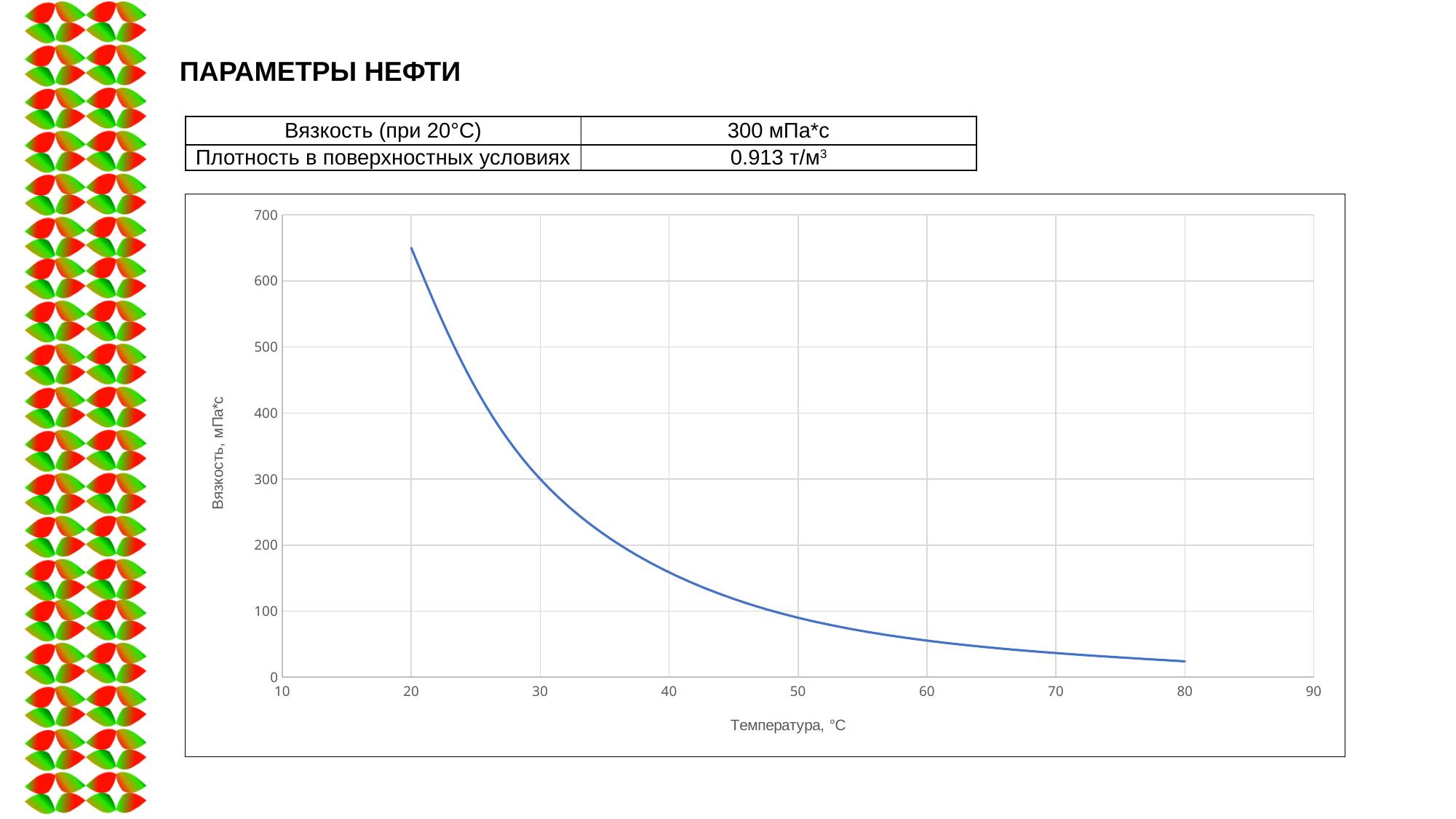
What is the label of the horizontal axis of the chart? Температура, °C What kind of chart is shown on the slide? line chart Is the viscosity value at 80 °C greater or less than 100? less Is the viscosity value at 40 °C greater or less than 100? greater Which temperature has the higher viscosity on the chart, 30 °C or 60 °C? 30 °C Is the viscosity value at 40 °C greater or less than 200? less Does the viscosity rise or fall as temperature increases along the x axis? fall What is the label of the vertical axis of the chart? Вязкость, мПа*с Which temperature has the higher viscosity on the chart, 20 °C or 80 °C? 20 °C